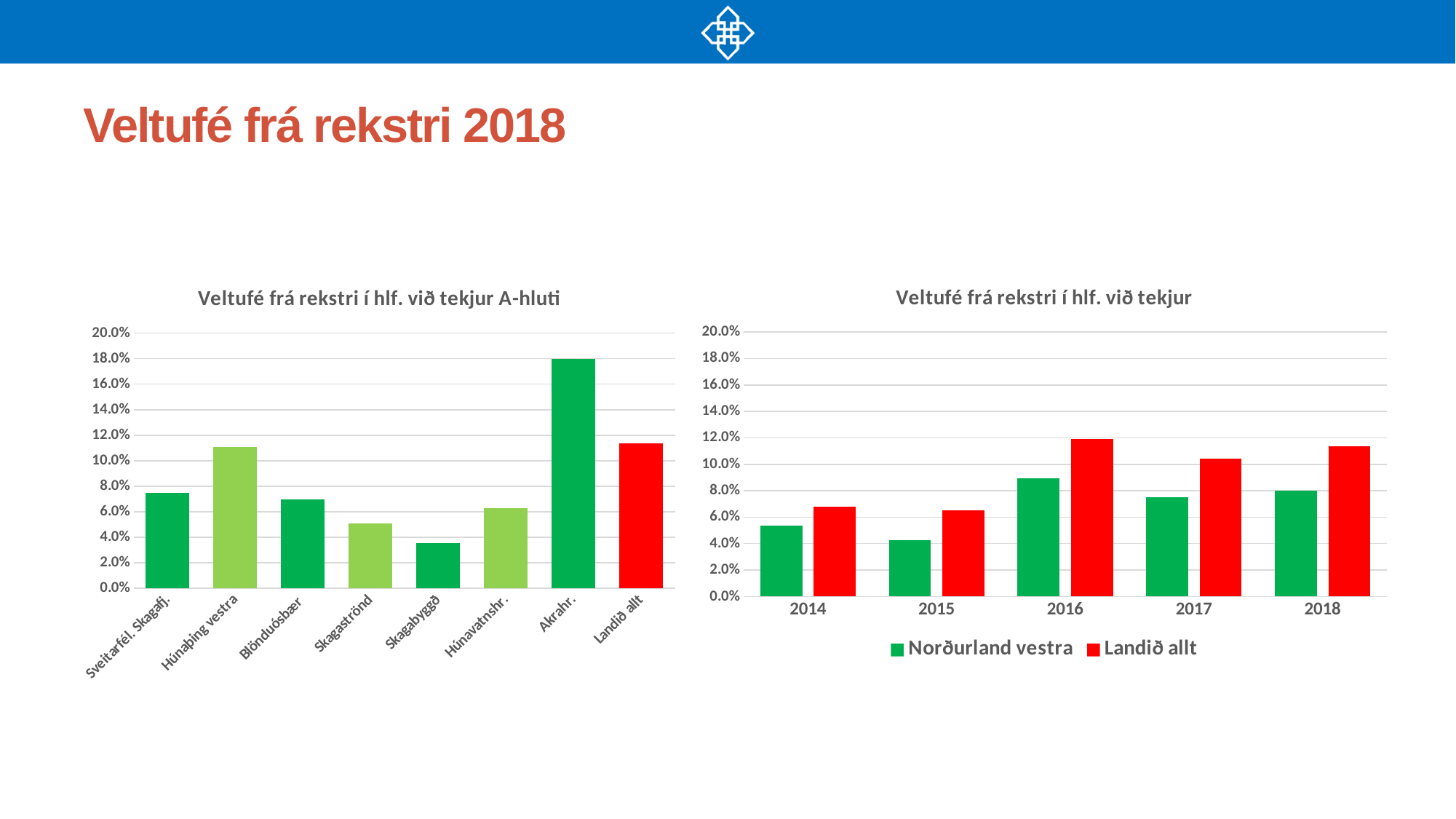
In the right chart (Veltufé frá rekstri í hlf. við tekjur), in which year is the Landið allt value highest? 2016 In the left chart (Veltufé frá rekstri í hlf. við tekjur A-hluti), which category has the lowest value? Skagabyggð In the left chart (Veltufé frá rekstri í hlf. við tekjur A-hluti), how many categories are shown on the x axis? 8 In the left chart (Veltufé frá rekstri í hlf. við tekjur A-hluti), is the value for Skagabyggð greater or less than 4.0%? less In the right chart (Veltufé frá rekstri í hlf. við tekjur), is the Landið allt value for 2018 greater or less than 10.0%? greater In the right chart (Veltufé frá rekstri í hlf. við tekjur), in which year is the Norðurland vestra value lowest? 2015 In the left chart (Veltufé frá rekstri í hlf. við tekjur A-hluti), which is larger, the value for Húnaþing vestra or the value for Blönduósbær? Húnaþing vestra In the right chart (Veltufé frá rekstri í hlf. við tekjur), which series is larger in 2017, Norðurland vestra or Landið allt? Landið allt In the right chart (Veltufé frá rekstri í hlf. við tekjur), how many series does the legend list? 2 In the left chart (Veltufé frá rekstri í hlf. við tekjur A-hluti), which category has the highest value? Akrahr. In the left chart (Veltufé frá rekstri í hlf. við tekjur A-hluti), is the value for Akrahr. greater or less than 16.0%? greater What kind of chart is the right chart (Veltufé frá rekstri í hlf. við tekjur)? bar chart